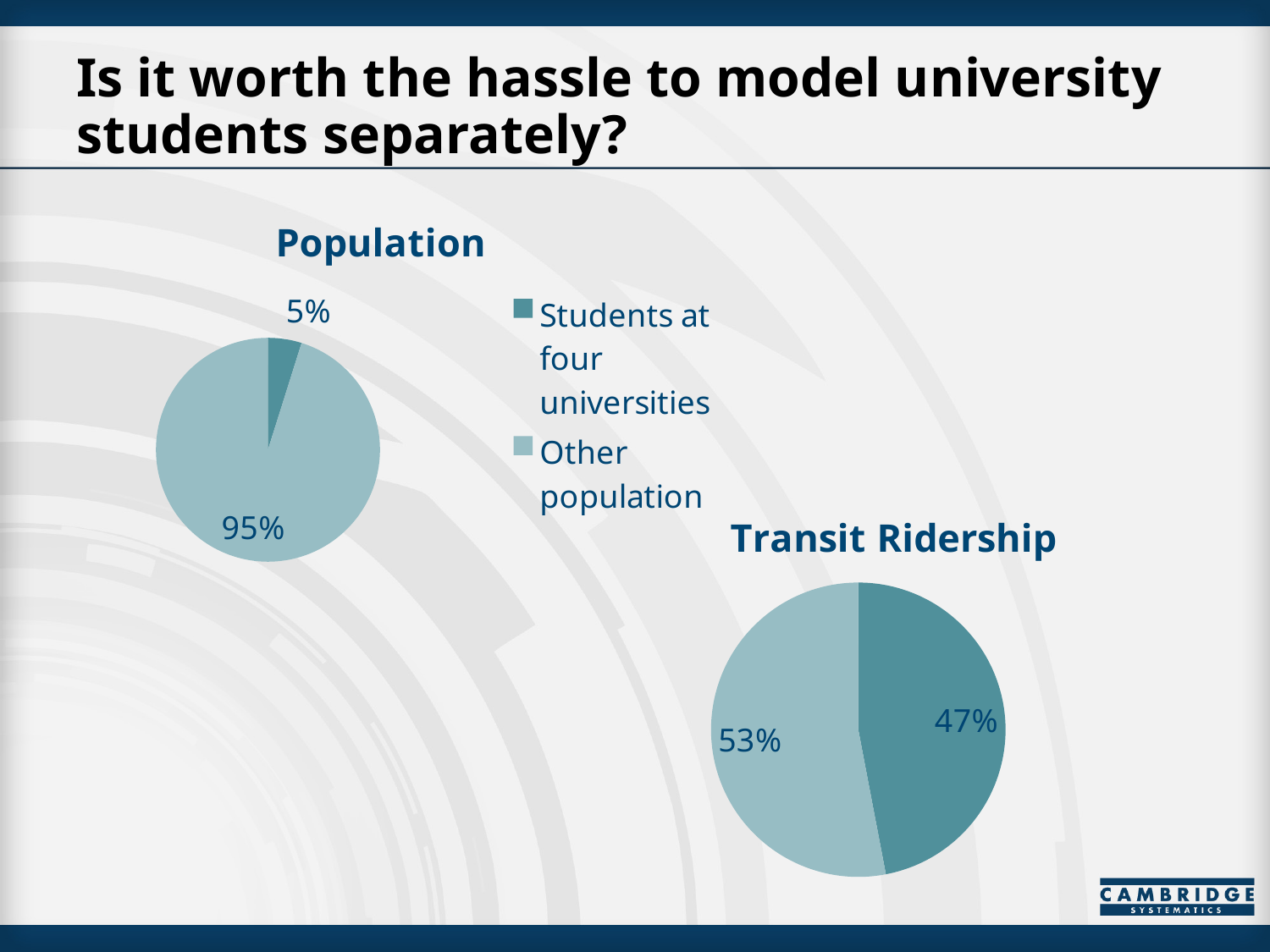
What kind of chart is the Population chart? Pie chart In the Population chart, which category has the smallest slice? Students at four universities In the Population chart, what share of the pie is Students at four universities? 5% In the Population chart, what share of the pie is Other population? 95% In the Transit Ridership chart, what share of the pie is Students at four universities? 47% In the Population chart, what is the difference between the Other population share and the Students at four universities share? 90% In the Population chart, which category has the largest slice? Other population In the Transit Ridership chart, which category has the larger slice? Other population In the Transit Ridership chart, what is the difference between the Other population share and the Students at four universities share? 6% Which is larger: the Students at four universities share in the Population chart or in the Transit Ridership chart? Transit Ridership How many categories does the legend list? 2